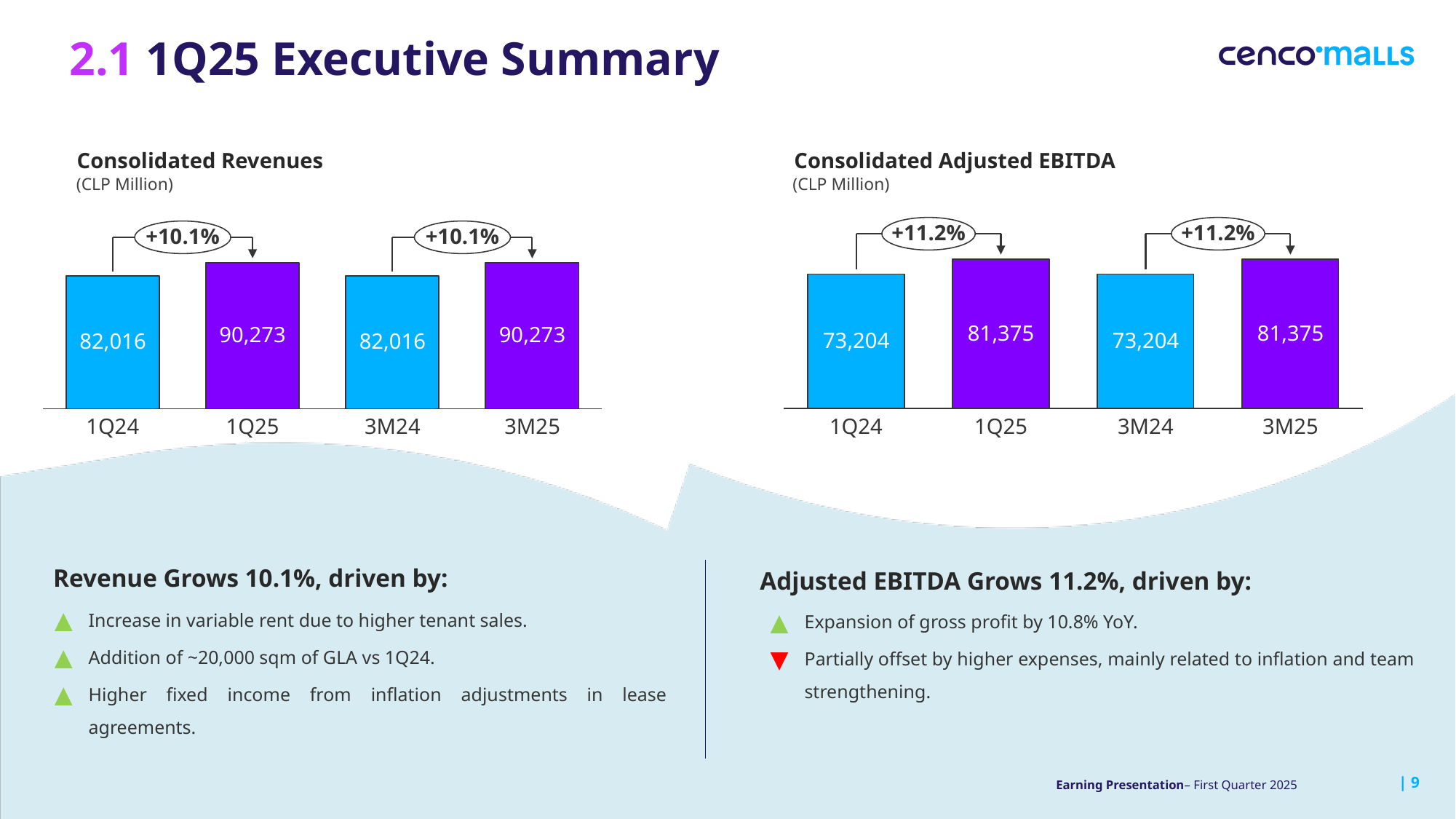
In the Consolidated Revenues chart, which is larger, 1Q24 or 1Q25? 1Q25 In the Consolidated Revenues chart, what is the value for 1Q24? 82,016 What kind of chart is the Consolidated Adjusted EBITDA chart? Bar chart In the Consolidated Revenues chart, what is the difference between the 1Q25 and 1Q24 values? 8,257 In the Consolidated Adjusted EBITDA chart, what percentage growth is shown from 3M24 to 3M25? +11.2% In the Consolidated Revenues chart, what percentage growth is shown from 1Q24 to 1Q25? +10.1% In the Consolidated Adjusted EBITDA chart, what is the difference between the 3M25 and 3M24 values? 8,171 In the Consolidated Adjusted EBITDA chart, which category has the lowest value? 1Q24 and 3M24 (both 73,204) In the Consolidated Adjusted EBITDA chart, what is the value for 1Q24? 73,204 How many bars are shown in the Consolidated Revenues chart? 4 In the Consolidated Adjusted EBITDA chart, what is the value for 3M25? 81,375 In the Consolidated Revenues chart, what is the value for 1Q25? 90,273